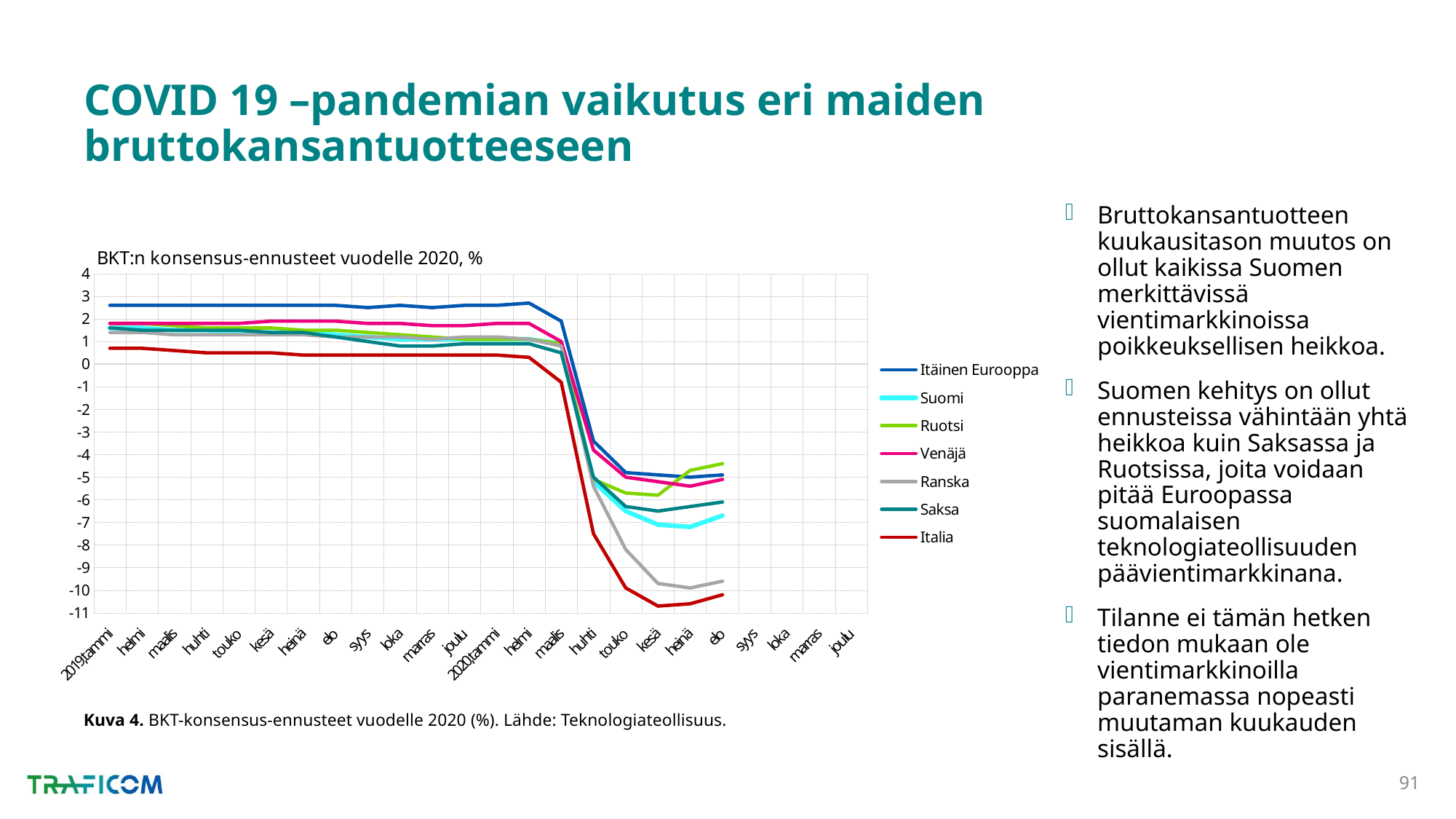
Is the value for Italia in kesä 2020 greater or less than -10? less Is the value for Ranska in kesä 2020 greater or less than -9? less Which series has the lowest value in elo 2020? Italia What is the title of the chart? BKT:n konsensus-ennusteet vuodelle 2020, % How many series does the legend list? 7 Which series is drawn in red? Italia Do the values for Italia rise or fall from maalis 2020 to kesä 2020? fall Is the value for Itäinen Eurooppa in 2019 tammi greater or less than 2? greater Which series has the highest value in 2019 tammi? Itäinen Eurooppa How many months are shown along the x axis? 24 What kind of chart is shown on the slide? line chart In elo 2020, which is larger: the value for Itäinen Eurooppa or the value for Italia? Itäinen Eurooppa